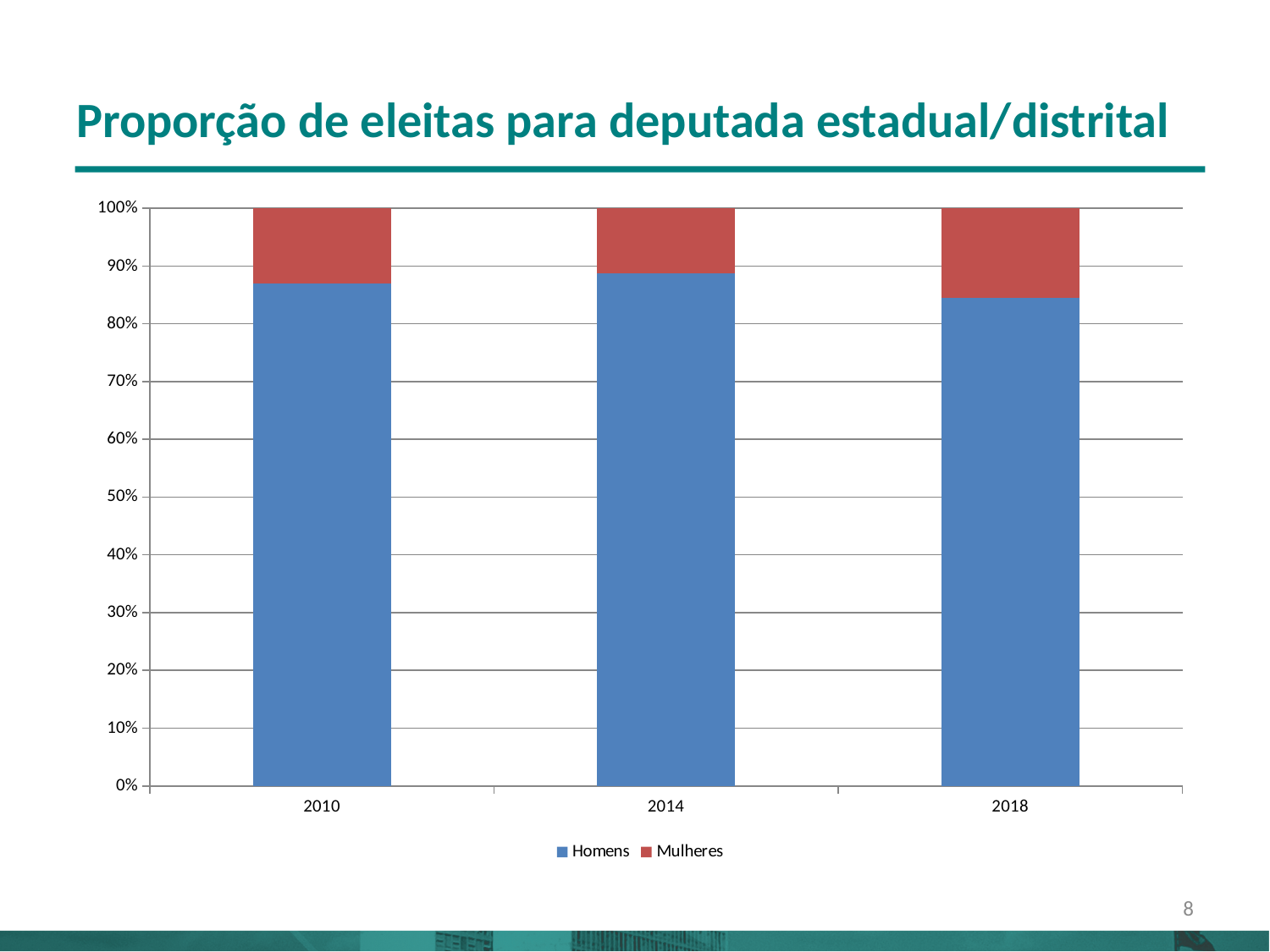
Is the value for Mulheres in 2014 greater or less than 20%? less Is the value for Mulheres in 2018 greater or less than 10%? greater Is the value for Homens in 2018 greater or less than 90%? less Which is larger, the Homens share in 2014 or in 2018? 2014 In which year is the Homens share the lowest? 2018 What kind of chart is shown on the slide? Stacked bar chart How many series does the legend list? 2 What are the two series named in the legend? Homens and Mulheres In which year is the Mulheres share the highest? 2018 How many years are shown on the x axis of the chart? 3 What is the title of the chart on the slide? Proporção de eleitas para deputada estadual/distrital